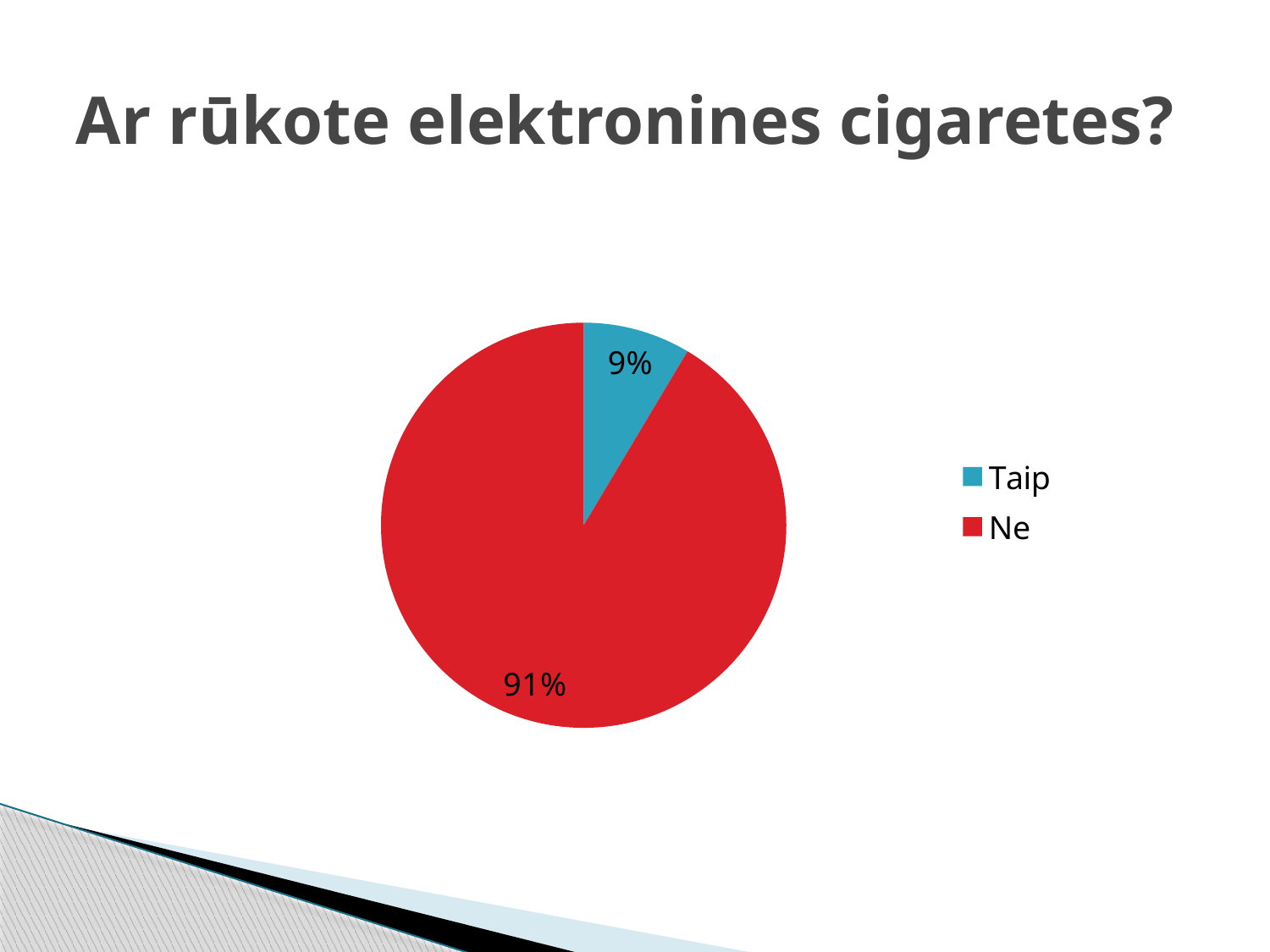
Which slice is larger, "Taip" or "Ne"? Ne What kind of chart is shown on the slide? pie chart Which category has the smallest slice of the pie? Taip What share of the pie does the "Ne" slice represent? 91% What colour is the "Taip" slice in the pie chart? blue What percentage of the pie is labelled for "Taip"? 9% What percentage of the pie is labelled for "Ne"? 91% How many slices does the pie chart have? 2 What is the title of the slide containing the pie chart? Ar rūkote elektronines cigaretes? What is the difference in percentage points between the "Ne" slice and the "Taip" slice? 82 How many entries does the legend list? 2 Which category has the largest slice of the pie? Ne